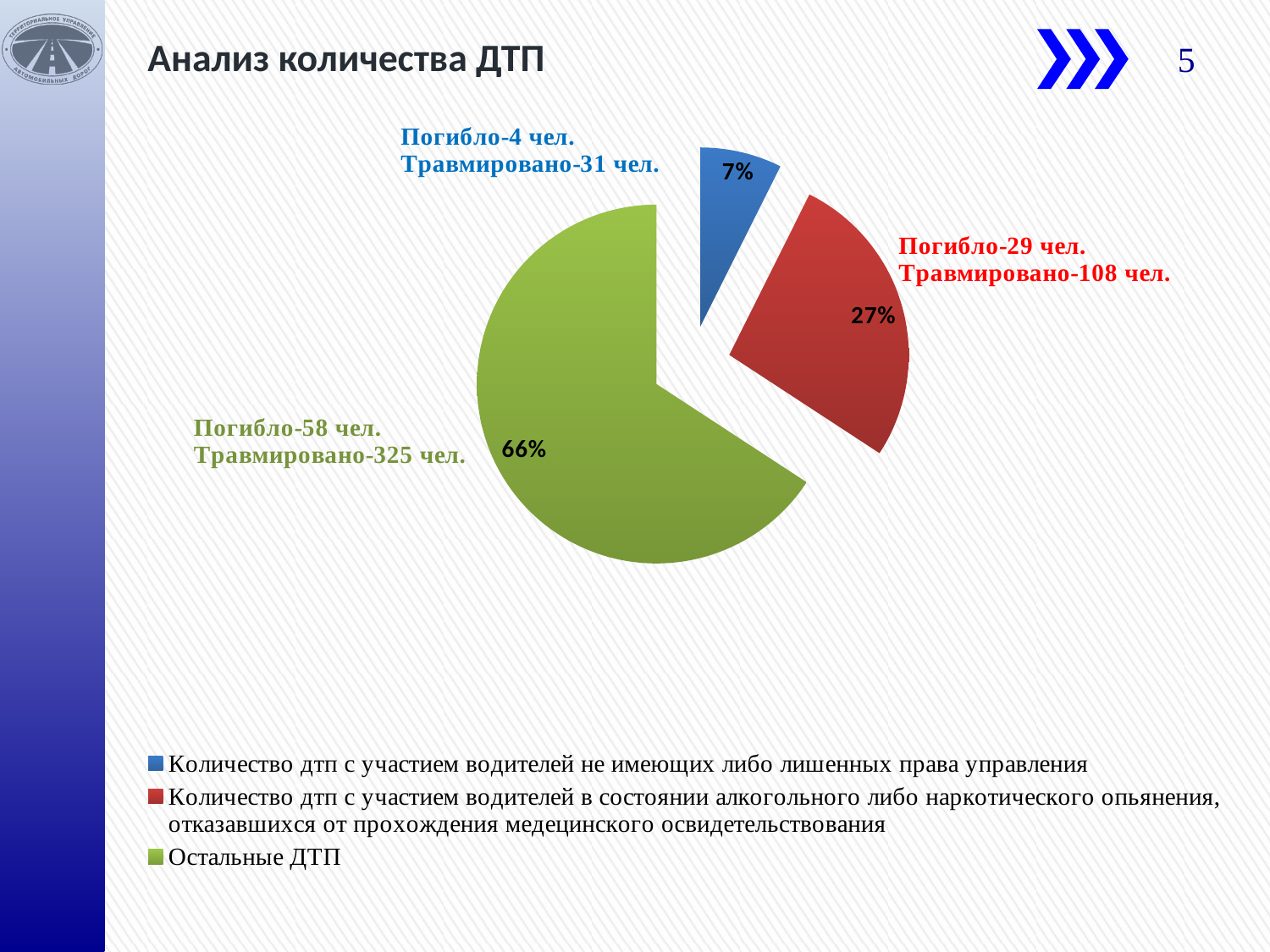
How many slices does the pie chart have? 3 Which slice of the pie is the smallest? Количество дтп с участием водителей не имеющих либо лишенных права управления How many people were killed (Погибло) according to the annotation next to the 27% slice? 29 чел. What kind of chart is shown on the slide? pie chart What is the difference in percentage points between the 66% slice and the 27% slice? 39 Which slice of the pie is the largest? Остальные ДТП What percentage is shown for the slice "Количество дтп с участием водителей не имеющих либо лишенных права управления"? 7% Which is larger: the share for drivers without a licence (blue) or the share for intoxicated drivers (red)? intoxicated drivers (red), 27% What share of the pie is labelled for "Остальные ДТП"? 66% What colour is the slice for "Остальные ДТП"? green What percentage is shown for the slice representing accidents involving drivers in a state of alcohol or drug intoxication? 27% How many entries does the legend list? 3